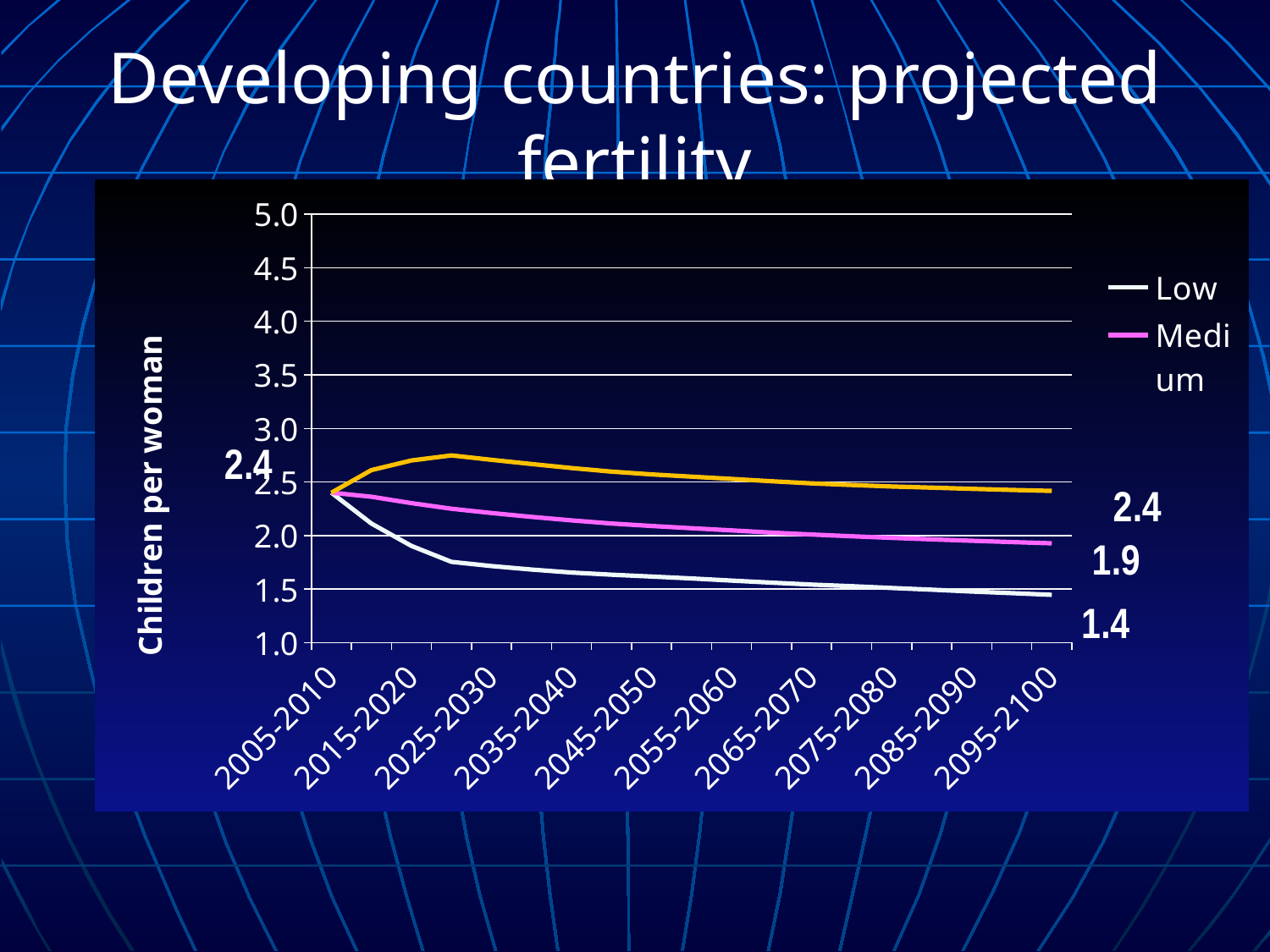
Does the Low series rise or fall from 2005-2010 to 2095-2100? fall What is the value shown for 2005-2010, where the lines start? 2.4 How many periods are labelled on the x axis? 10 How many series does the legend list? 2 What kind of chart is shown on the slide? line chart Is the value of the Low series for 2025-2030 greater or less than 2.0? less What is the value of the Low series for 2095-2100? 1.4 Does the Medium series rise or fall from 2005-2010 to 2095-2100? fall What is the label on the y axis? Children per woman Which is larger for 2095-2100, the Low value or the Medium value? Medium What is the value of the Medium series for 2095-2100? 1.9 What is the difference between the Medium and Low values for 2095-2100? 0.5